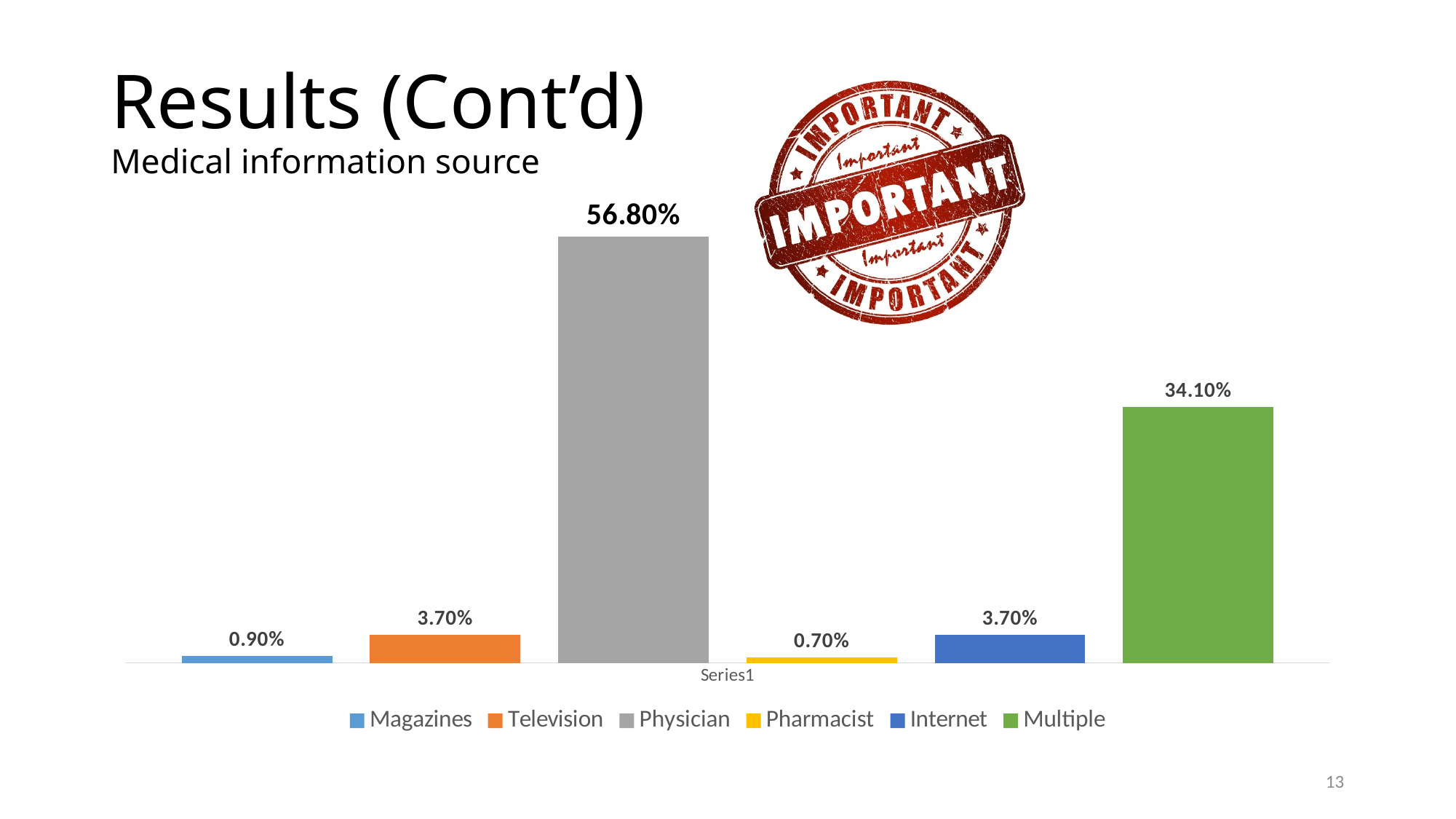
What colour is the bar for Multiple? Green What is the value for Multiple? 34.10% What is the value for Pharmacist? 0.70% What is the value for Television? 3.70% Which medical information source has the highest value? Physician How many series does the legend list? 6 What is the difference between the values for Physician and Multiple? 22.70% What is the value for Physician? 56.80% Which medical information source has the lowest value? Pharmacist Which is larger, the value for Multiple or the value for Television? Multiple What is the value for Magazines? 0.90% What kind of chart is shown on the slide? Bar chart